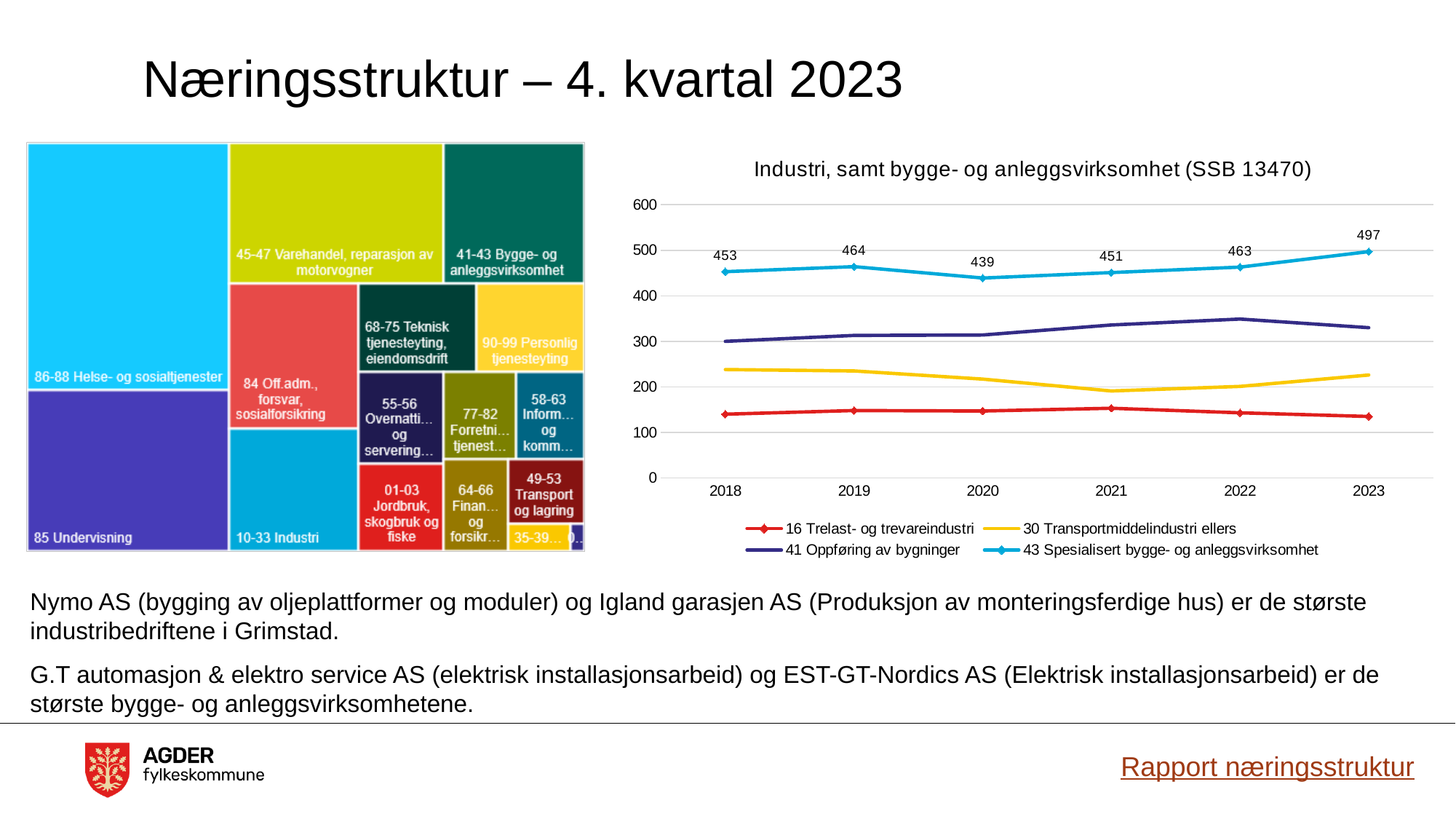
In the line chart on the right, how many years are shown on the x axis? 6 In the line chart on the right, which series has the highest values across all years? 43 Spesialisert bygge- og anleggsvirksomhet In the line chart on the right, in which year is the value for '43 Spesialisert bygge- og anleggsvirksomhet' lowest? 2020 In the line chart on the right, is the value for '41 Oppføring av bygninger' in 2022 greater or less than 300? greater In the line chart on the right, how many series does the legend list? 4 In the line chart on the right, in which year is the value for '43 Spesialisert bygge- og anleggsvirksomhet' highest? 2023 In the line chart on the right, what is the difference between the 2023 and 2022 values for '43 Spesialisert bygge- og anleggsvirksomhet'? 34 What kind of chart is shown on the left of the slide? Treemap In the line chart titled 'Industri, samt bygge- og anleggsvirksomhet (SSB 13470)', what is the value for '43 Spesialisert bygge- og anleggsvirksomhet' in 2023? 497 In the line chart on the right, what is the value for '43 Spesialisert bygge- og anleggsvirksomhet' in 2020? 439 In the line chart on the right, is the 2019 value for '43 Spesialisert bygge- og anleggsvirksomhet' larger or smaller than the 2021 value? larger